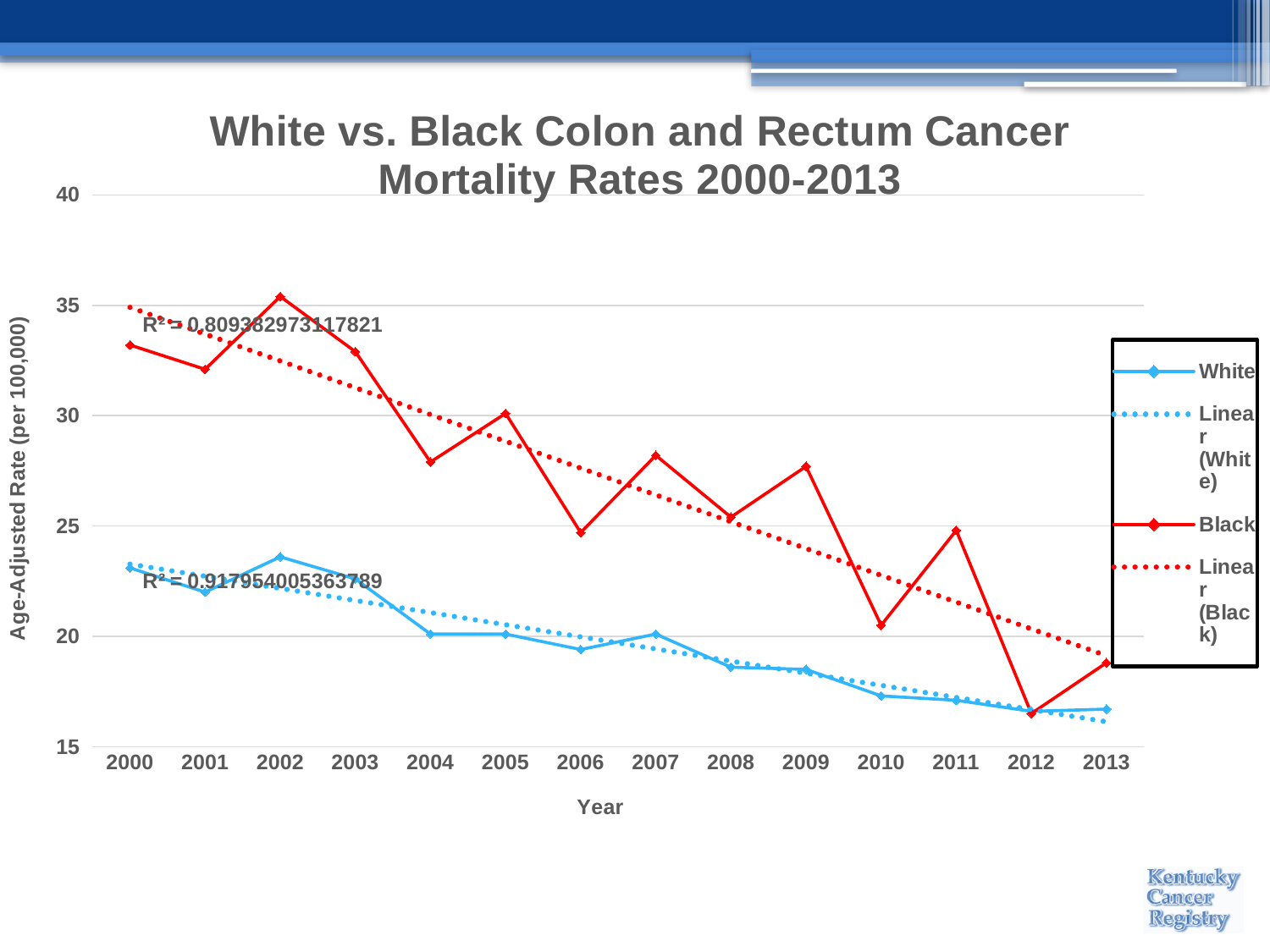
What is the title of the y axis? Age-Adjusted Rate (per 100,000) What kind of chart is shown on the slide? Line chart Is the White mortality rate in 2002 greater or less than 20? greater Overall, do the White and Black mortality rates rise or fall from 2000 to 2013? Fall How many years are plotted along the x axis? 14 Is the Black mortality rate in 2000 greater or less than 30? greater In which year is the Black mortality rate highest? 2002 In which year is the Black mortality rate lowest? 2012 Is the Black mortality rate in 2009 greater or less than 25? greater How many entries does the legend list? 4 Which is larger in 2000, the White rate or the Black rate? Black